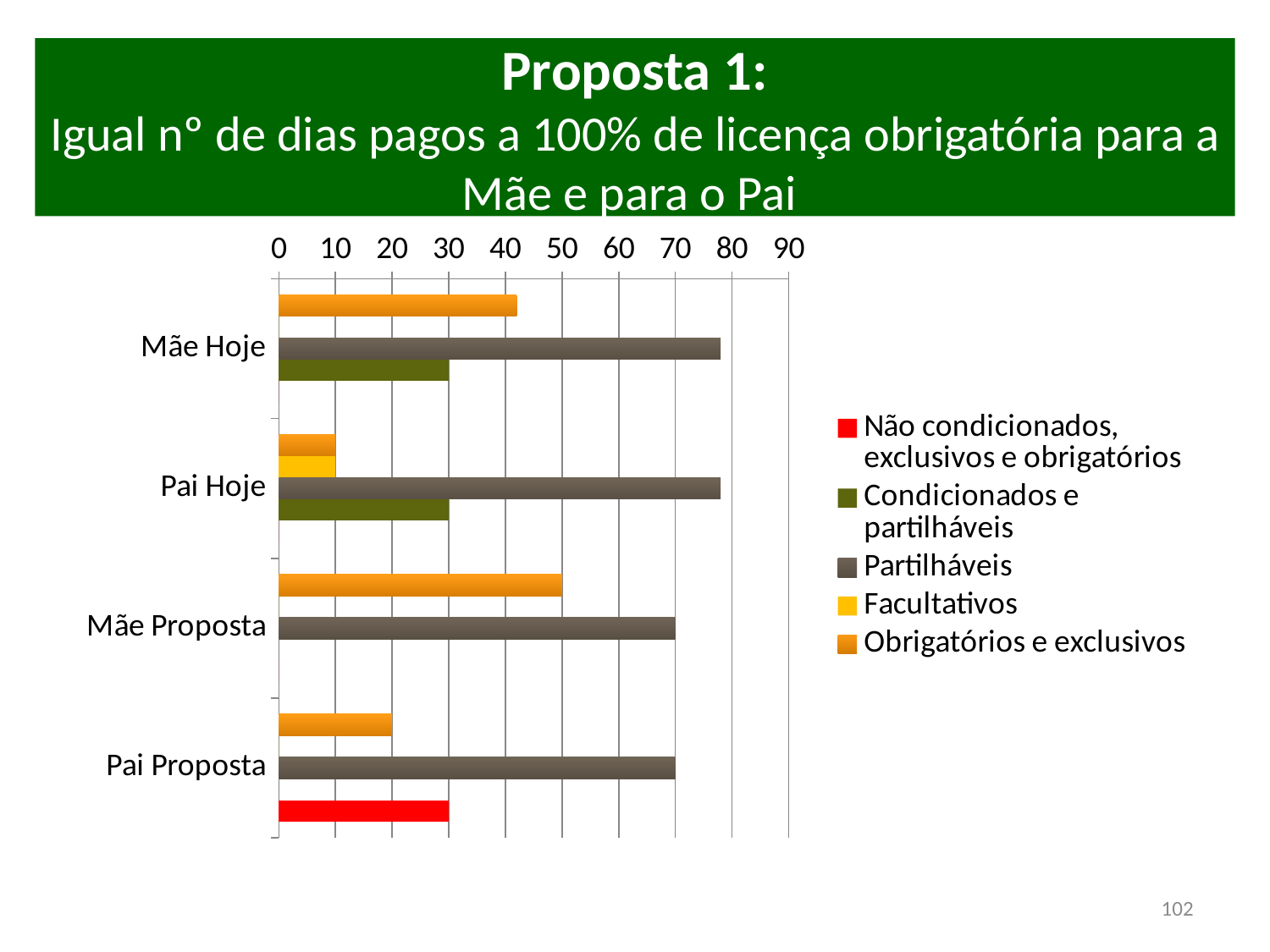
Is the value of 'Obrigatórios e exclusivos' for Mãe Hoje greater or less than 50? less What is the value of 'Não condicionados, exclusivos e obrigatórios' for Pai Proposta? 30 Is the value of 'Partilháveis' for Mãe Hoje greater or less than 70? greater What kind of chart is shown on the slide? bar chart How many categories are shown on the vertical axis of the chart? 4 What is the difference between the 'Obrigatórios e exclusivos' values for Mãe Proposta and Pai Proposta? 30 What is the value of 'Obrigatórios e exclusivos' for Pai Proposta? 20 How many series does the chart legend list? 5 Which category has the highest value for 'Obrigatórios e exclusivos'? Mãe Proposta Which series is shown in red in the legend? Não condicionados, exclusivos e obrigatórios What is the value of 'Obrigatórios e exclusivos' for Mãe Proposta? 50 What is the value of 'Partilháveis' for Pai Proposta? 70